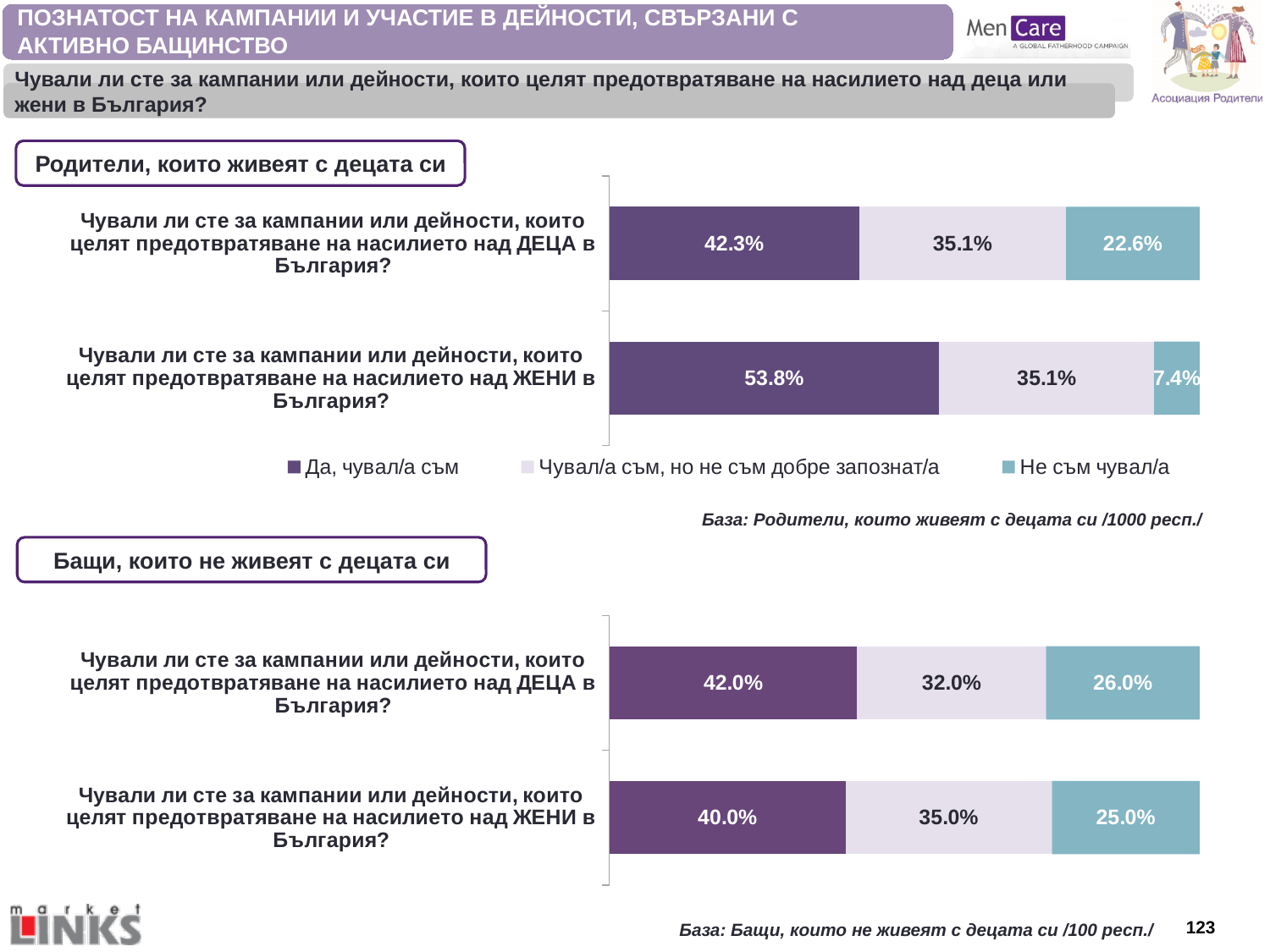
In the bottom chart (Бащи, които не живеят с децата си), what percentage is shown in the teal segment ("Не съм чувал/а") for the question about violence against ДЕЦА? 26.0% In the top chart (Родители, които живеят с децата си), what percentage answered "Не съм чувал/а" for the question about violence against ЖЕНИ? 7.4% In the top chart (Родители, които живеят с децата си), what is the difference between the "Да, чувал/а съм" shares for the ЖЕНИ question and the ДЕЦА question? 11.5 percentage points In the top chart (Родители, които живеят с децата си), which question has the higher share of "Да, чувал/а съм": the one about ДЕЦА or the one about ЖЕНИ? ЖЕНИ In the top chart (Родители, които живеят с децата си), what percentage answered "Да, чувал/а съм" for the question about violence against ДЕЦА? 42.3% In the bottom chart (Бащи, които не живеят с децата си), what percentage is shown in the dark purple segment ("Да, чувал/а съм") for the question about violence against ЖЕНИ? 40.0% According to the base note under the bottom chart, how many respondents are in the group "Бащи, които не живеят с децата си"? 100 респ. What type of chart is used on this slide? Stacked bar chart In the bottom chart (Бащи, които не живеят с децата си), what is the difference between the light segment ("Чувал/а съм, но не съм добре запознат/а") values for the ЖЕНИ question and the ДЕЦА question? 3.0 percentage points How many bars (questions) are shown in the bottom chart (Бащи, които не живеят с децата си)? 2 In the top chart (Родители, които живеят с децата си), what percentage answered "Чувал/а съм, но не съм добре запознат/а" for the question about violence against ДЕЦА? 35.1% How many series does the legend of the top chart (Родители, които живеят с децата си) list? 3